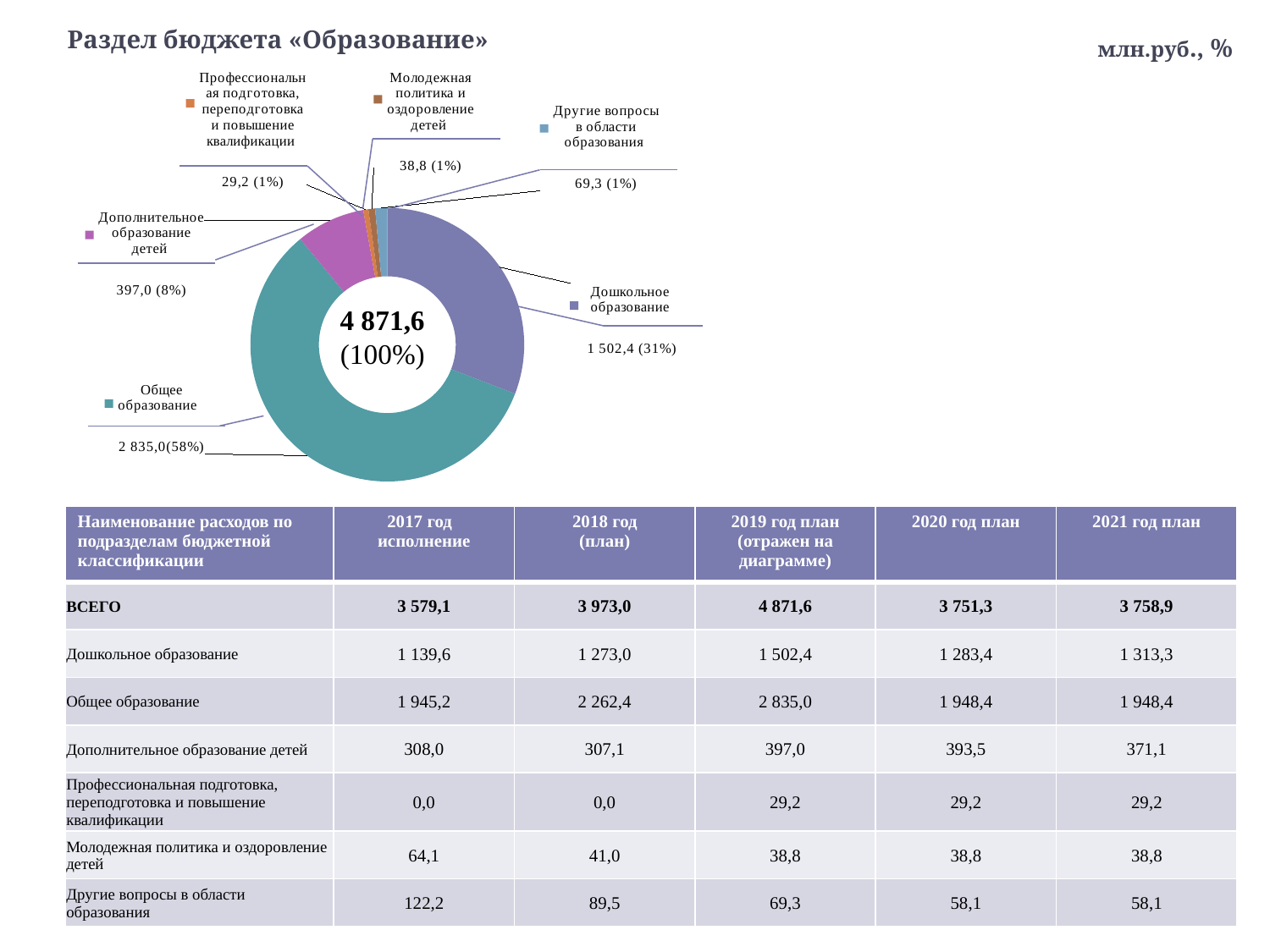
What share of the pie does Дошкольное образование represent? 31% What is the value shown for Общее образование in the pie chart? 2 835,0 How many categories does the pie chart show? 6 What is the value shown for Другие вопросы в области образования in the pie chart? 69,3 Which category has the largest slice in the pie chart? Общее образование What total value is shown in the centre of the pie chart? 4 871,6 What is the difference between the values for Общее образование and Дошкольное образование in the pie chart? 1 332,6 What is the value shown for Дошкольное образование in the pie chart? 1 502,4 What kind of chart is shown on the slide? Pie (donut) chart Which category has the smallest slice in the pie chart? Профессиональная подготовка, переподготовка и повышение квалификации What share of the pie does Общее образование represent? 58% What is the value shown for Дополнительное образование детей in the pie chart? 397,0